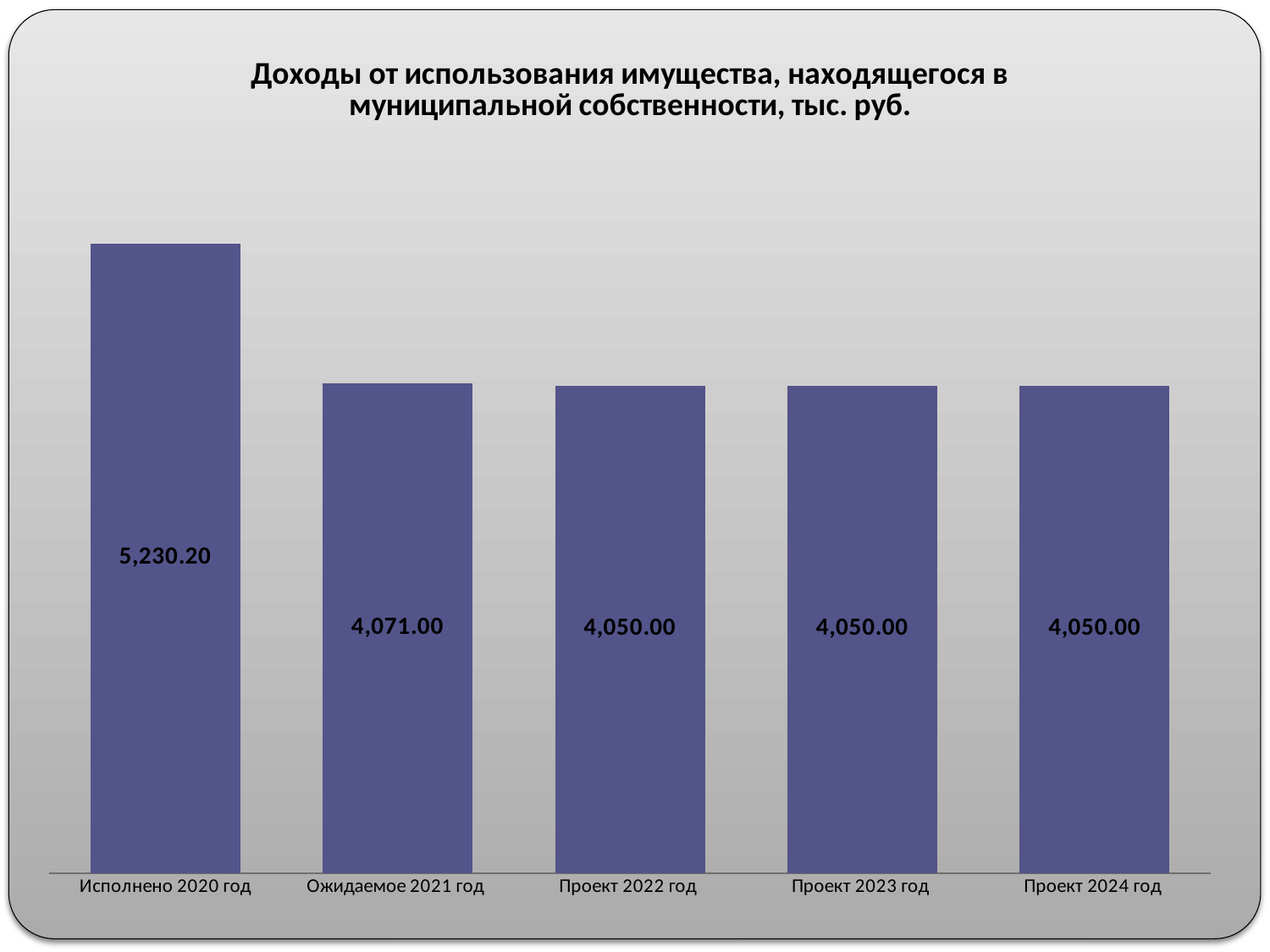
What kind of chart is shown on the slide? Bar chart Do the values rise or fall from Исполнено 2020 год to Проект 2024 год? Fall What is the value for Проект 2024 год? 4,050.00 What is the value for Ожидаемое 2021 год? 4,071.00 What unit is stated in the chart title? тыс. руб. What is the value for Проект 2022 год? 4,050.00 Which is larger, the value for Исполнено 2020 год or the value for Проект 2023 год? Исполнено 2020 год What is the value for Исполнено 2020 год? 5,230.20 Which category has the highest value? Исполнено 2020 год What is the difference between the values for Исполнено 2020 год and Ожидаемое 2021 год? 1,159.20 What is the difference between the values for Ожидаемое 2021 год and Проект 2022 год? 21.00 How many categories are shown on the chart? 5